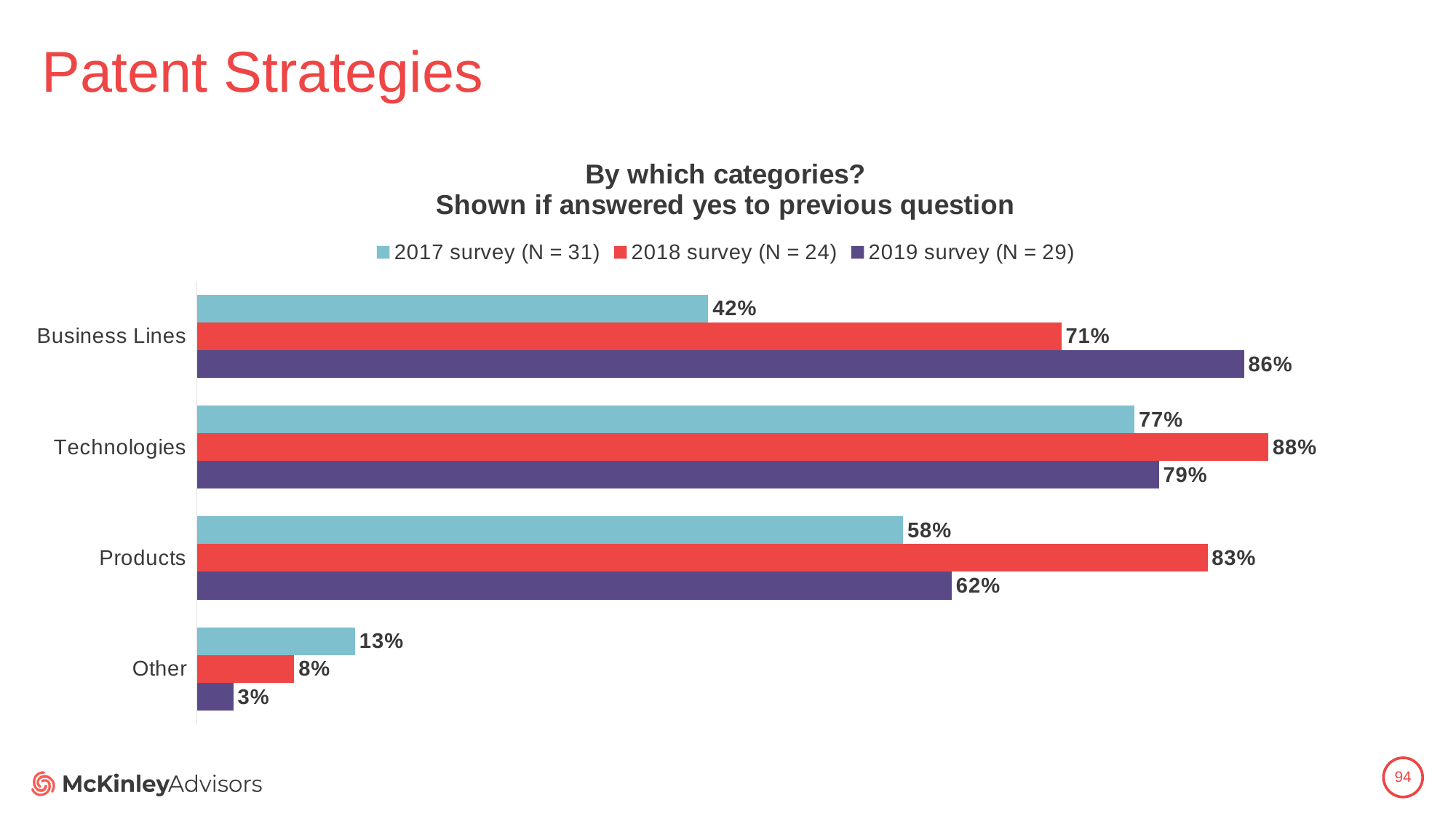
What is the value for Products in the 2017 survey (N = 31)? 58% Which category has the lowest value in the 2019 survey (N = 29)? Other What is the difference between the 2018 survey and 2017 survey values for Business Lines? 29% Which category has the highest value in the 2018 survey (N = 24)? Technologies What is the value for Business Lines in the 2019 survey (N = 29)? 86% How many categories are shown on the chart? 4 Which colour represents the 2017 survey (N = 31) series? Light blue How many series does the legend list? 3 What is the value for Other in the 2018 survey (N = 24)? 8% Which is larger for Technologies: the 2017 survey value or the 2019 survey value? 2019 survey What is the difference between the 2018 survey and 2019 survey values for Products? 21% What kind of chart is shown on the slide? Bar chart